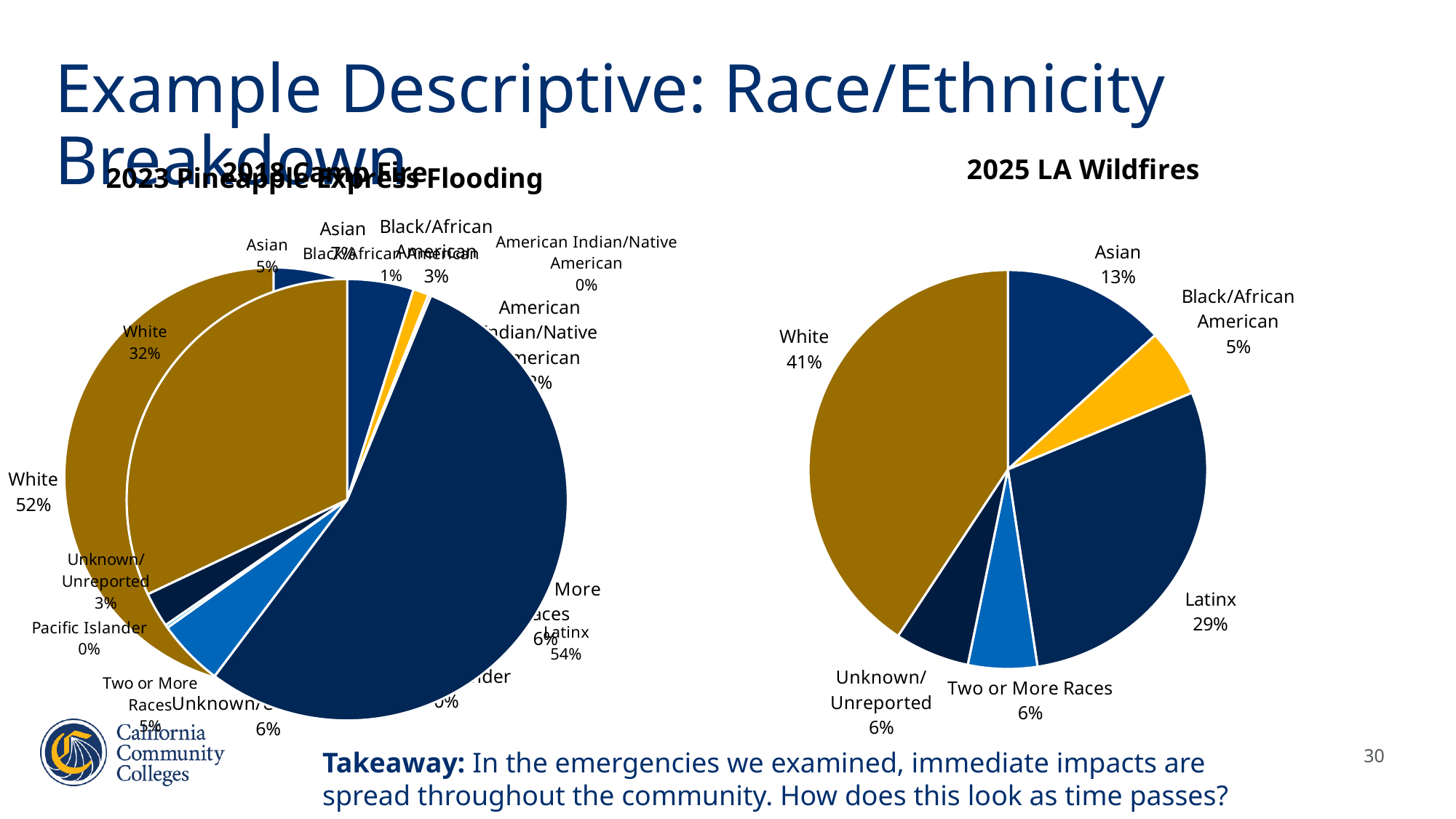
In the 2025 LA Wildfires chart, what share is Two or More Races? 6% In the 2025 LA Wildfires chart, which is larger, Asian or Latinx? Latinx In the 2025 LA Wildfires chart, which category has the largest share? White How many categories are shown in the 2025 LA Wildfires chart? 6 In the 2025 LA Wildfires chart, what share is Latinx? 29% In the 2025 LA Wildfires chart, what share is Unknown/Unreported? 6% In the 2025 LA Wildfires chart, what share is Asian? 13% In the 2025 LA Wildfires chart, what share is Black/African American? 5% In the 2025 LA Wildfires chart, which category has the smallest share? Black/African American In the 2025 LA Wildfires chart, what is the difference between the White and Latinx shares? 12% In the 2025 LA Wildfires chart, what share is White? 41% What kind of chart is the 2025 LA Wildfires chart? Pie chart